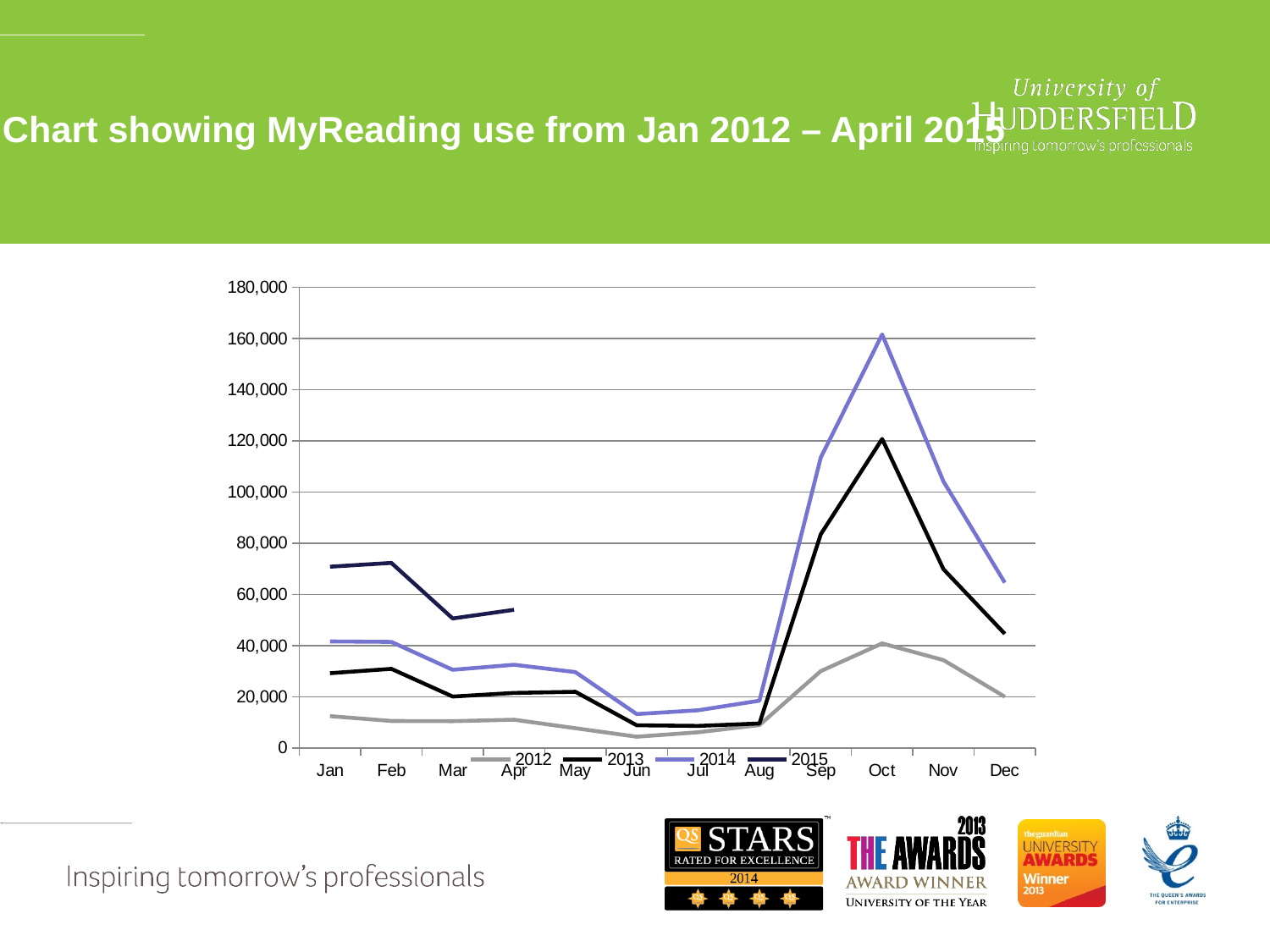
What kind of chart is shown on the slide? line chart Is the value for 2015 in Jan greater or less than 60,000? greater How many series does the legend list? 4 Is the value for 2012 in Oct greater or less than 60,000? less How many months are shown along the x axis? 12 In which month does the 2014 series reach its highest value? Oct Which series has the larger value in Oct, 2013 or 2014? 2014 Which series only has data plotted from Jan to Apr? 2015 Does the 2014 series rise or fall from Aug to Oct? rise In which month does the 2014 series reach its lowest value? Jun Is the value for 2013 in Oct greater or less than 100,000? greater